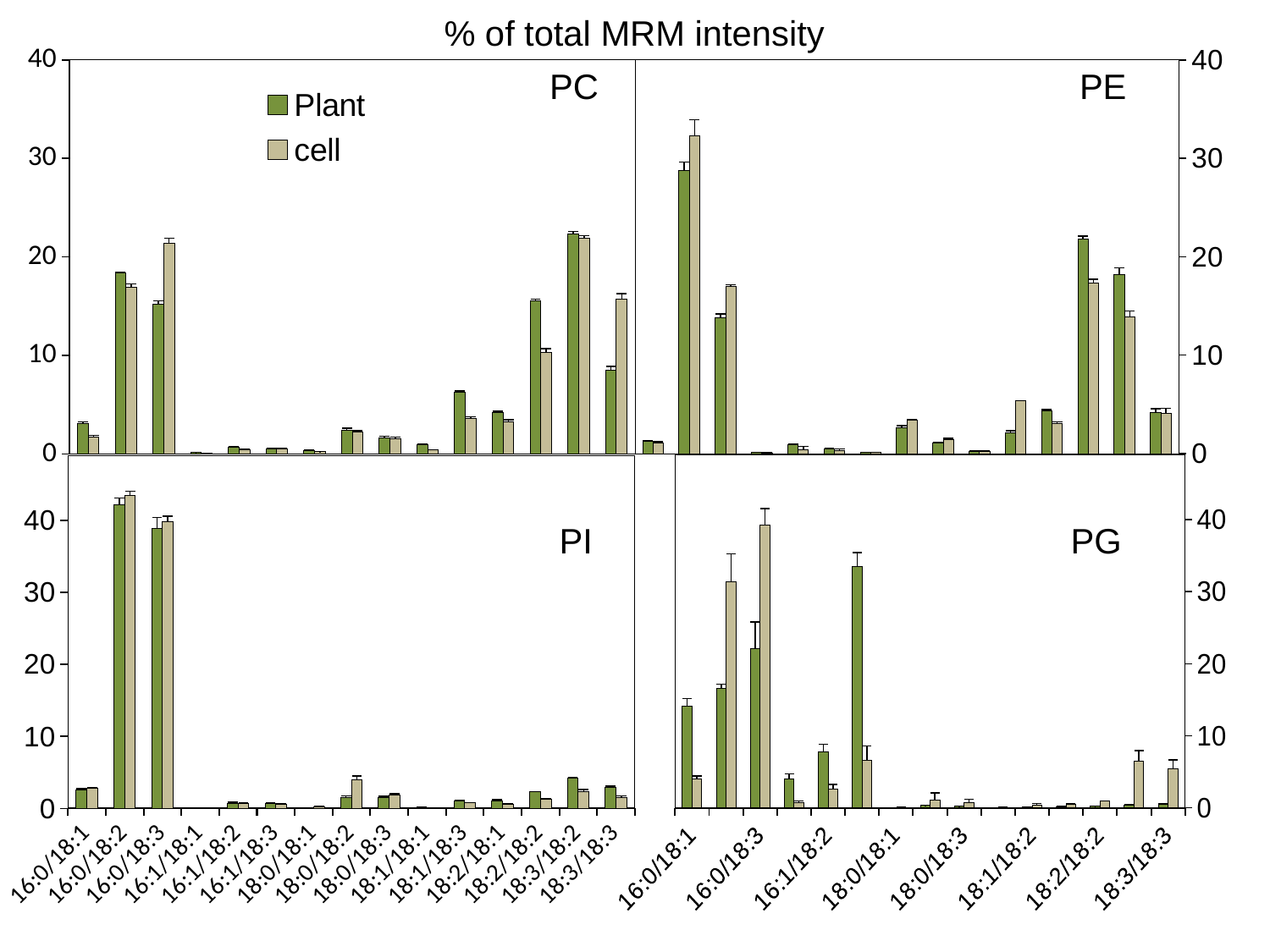
In the PC panel (top left), how many categories are labelled on the x axis? 15 What is the overall title shown above the charts? % of total MRM intensity In the PI panel (bottom left), is the Plant value for 16:0/18:2 greater or less than 40? greater In the PC panel (top left), is the cell value for 16:0/18:3 greater or less than 20? greater What kind of chart is used in each of the four panels on the slide? Bar chart In the PE panel (top right), which category has the highest cell value? 16:0/18:2 In the PC panel (top left), for 16:0/18:3, which series has the larger value, Plant or cell? cell In the PI panel (bottom left), which category has the highest Plant value? 16:0/18:2 How many series does the legend list? 2 In the PE panel (top right), is the cell value for 16:0/18:1 greater or less than 30? less